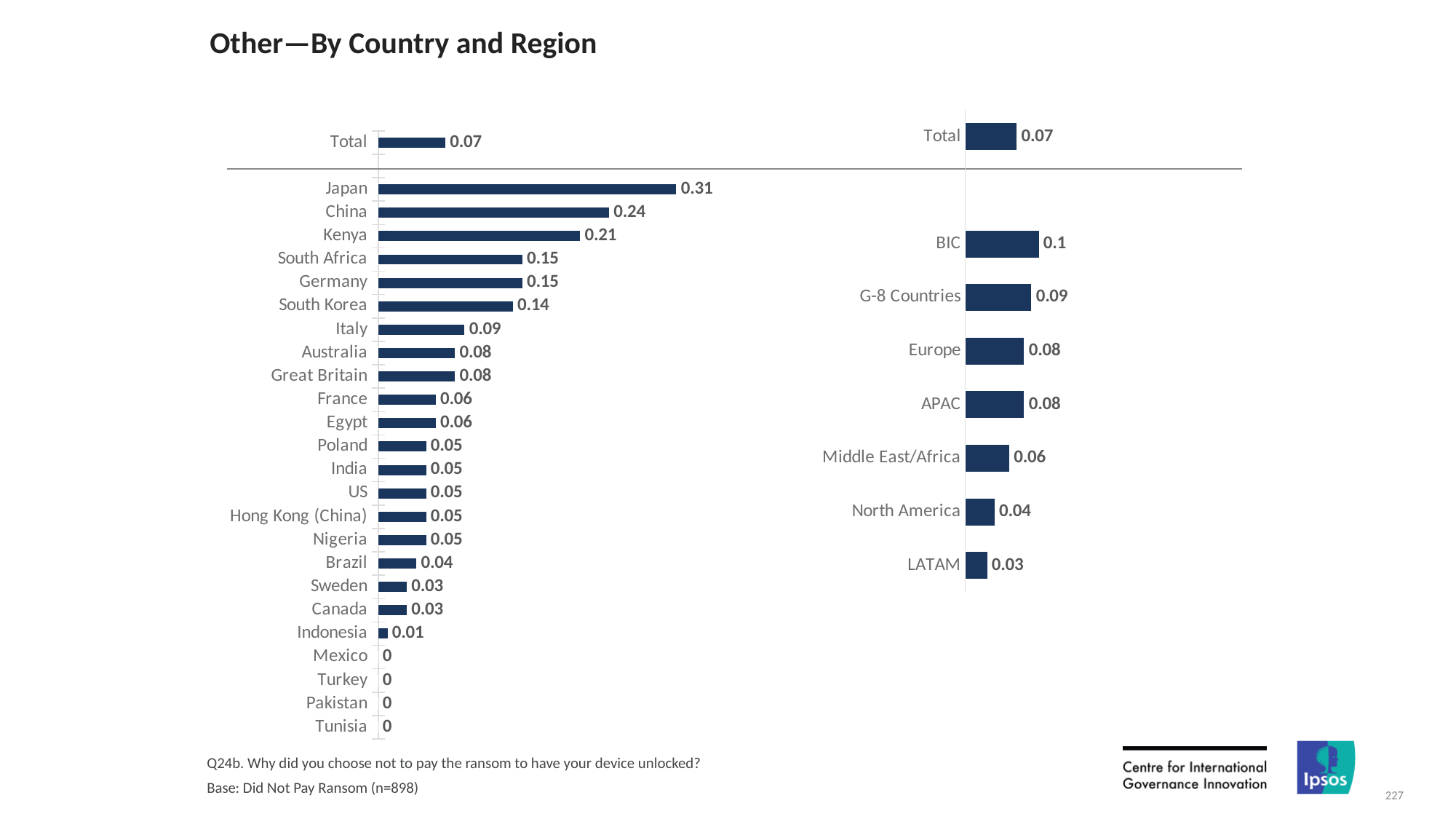
In the left chart (by country), which is larger, the value for South Korea or the value for Italy? South Korea In the right chart (by region), what is the value for G-8 Countries? 0.09 In the left chart (by country), how many countries have a value of 0? 4 In the right chart (by region), which region has the highest value? BIC In the left chart (by country), which country has the highest value? Japan In the left chart (by country), what is the value for Kenya? 0.21 In the left chart (by country), what is the difference between the values for Japan and China? 0.07 In the right chart (by region), what is the value for LATAM? 0.03 What type of chart is the right chart (by region)? Bar chart In the right chart (by region), what is the difference between the values for BIC and North America? 0.06 In the right chart (by region), which region has the lowest value? LATAM In the left chart (by country), what is the value for Japan? 0.31